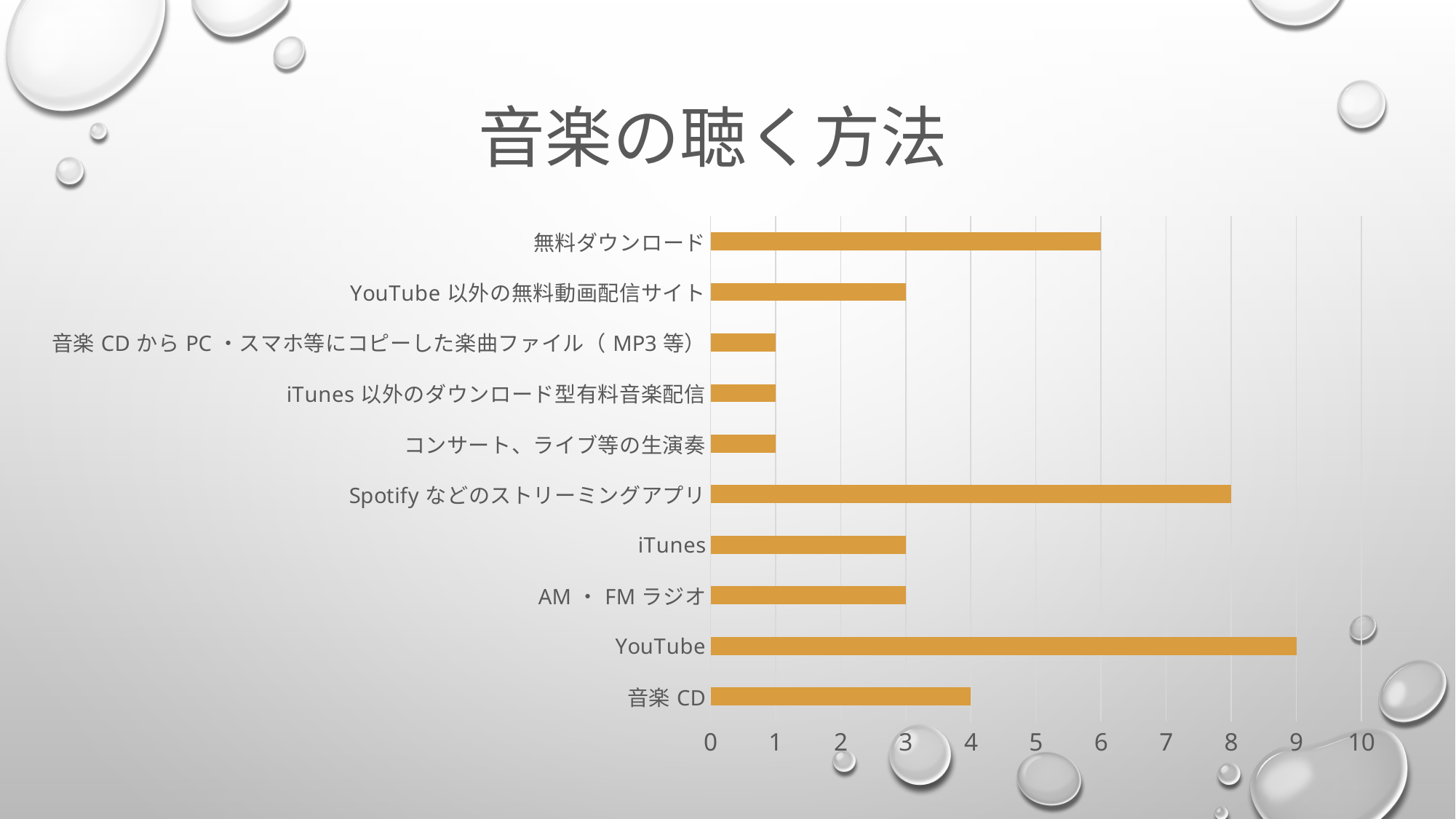
Which is larger, the value for 無料ダウンロード or the value for 音楽 CD? 無料ダウンロード What is the value for YouTube? 9 What is the value for 無料ダウンロード? 6 What kind of chart is shown on the slide? bar chart How many categories are plotted in the chart? 10 What is the value for iTunes? 3 What is the value for Spotify などのストリーミングアプリ? 8 Is the value for コンサート、ライブ等の生演奏 greater or less than 2? less What is the title of the chart? 音楽の聴く方法 Which category has the highest value? YouTube What is the difference between the values for YouTube and Spotify などのストリーミングアプリ? 1 What is the value for 音楽 CD? 4